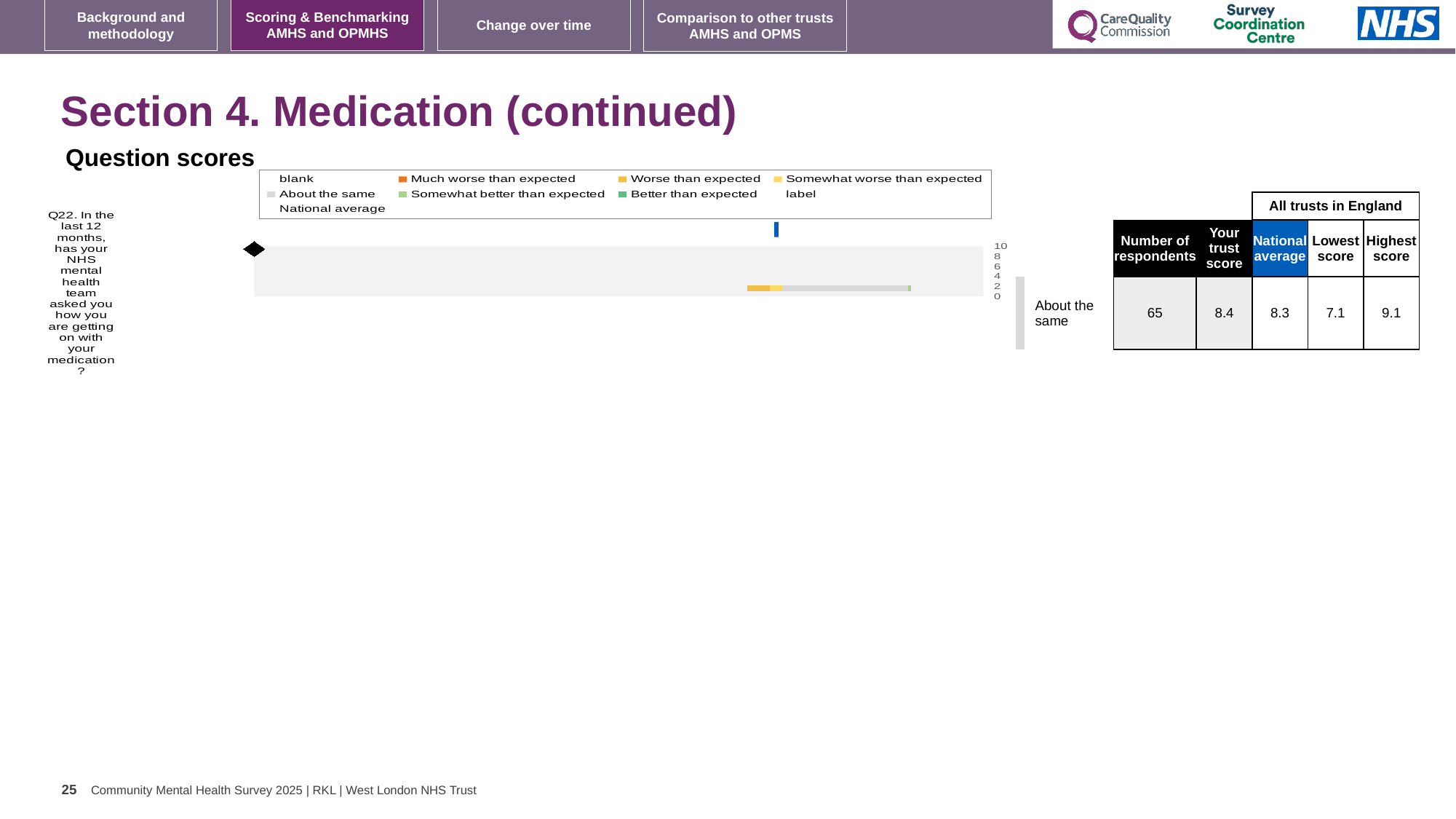
What benchmark category label is shown to the right of the Q22 bar? About the same What is the trust's score for Q22 shown in the table beside the chart? 8.4 Which question number is plotted in the Question scores chart? Q22 How many respondents answered Q22? 65 What is the difference between the highest and lowest trust scores for Q22? 2.0 What kind of chart is used to show the Q22 question score? bar chart How many questions are plotted in the Question scores chart? 1 Which is larger for Q22, the trust's score or the national average? the trust's score How many entries does the legend of the Question scores chart list? 9 What is the national average score for Q22 shown beside the chart? 8.3 What is the highest score among all trusts in England for Q22? 9.1 What is the lowest score among all trusts in England for Q22? 7.1